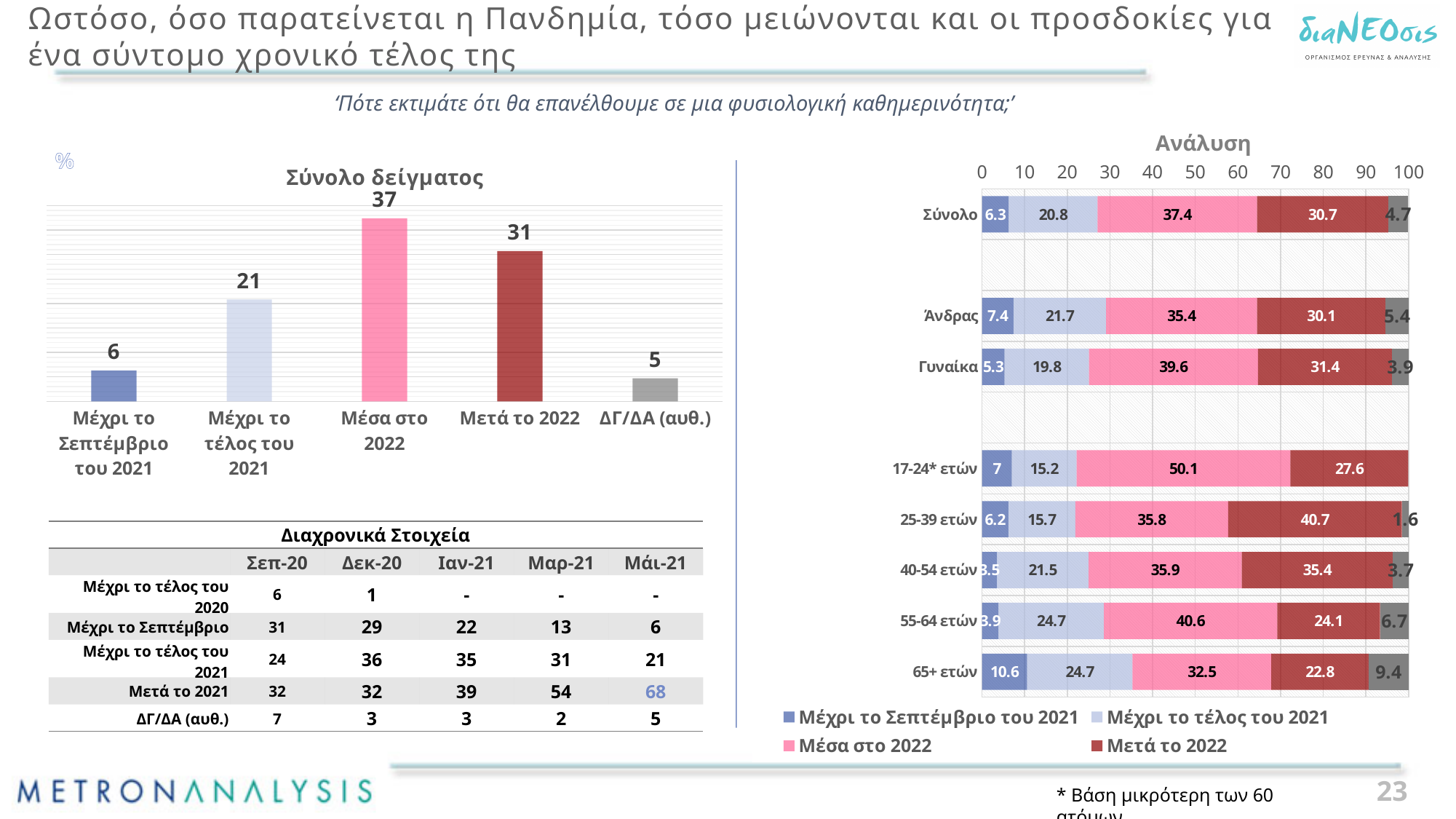
In the 'Σύνολο δείγματος' chart, which category has the highest value? Μέσα στο 2022 What kind of chart is the 'Σύνολο δείγματος' chart? Bar chart How many series does the legend of the 'Ανάλυση' chart list? 4 In the 'Σύνολο δείγματος' chart, what is the difference between 'Μέσα στο 2022' and 'Μετά το 2022'? 6 In the 'Σύνολο δείγματος' chart, which category has the lowest value? ΔΓ/ΔΑ (αυθ.) In the 'Ανάλυση' chart, what is the value of 'Μέσα στο 2022' for '17-24* ετών'? 50.1 In the 'Ανάλυση' chart, what is the value of 'Μετά το 2022' for '25-39 ετών'? 40.7 In the 'Σύνολο δείγματος' chart, how many categories are shown? 5 In the 'Ανάλυση' chart, which is larger for 'Γυναίκα': 'Μέσα στο 2022' or 'Μετά το 2022'? Μέσα στο 2022 In the 'Ανάλυση' chart, what is the difference between the 'Μέχρι το Σεπτέμβριο του 2021' values for 'Άνδρας' and 'Γυναίκα'? 2.1 In the 'Σύνολο δείγματος' chart, what is the value for 'Μέσα στο 2022'? 37 In the 'Ανάλυση' chart, which colour represents 'Μετά το 2022'? Dark red